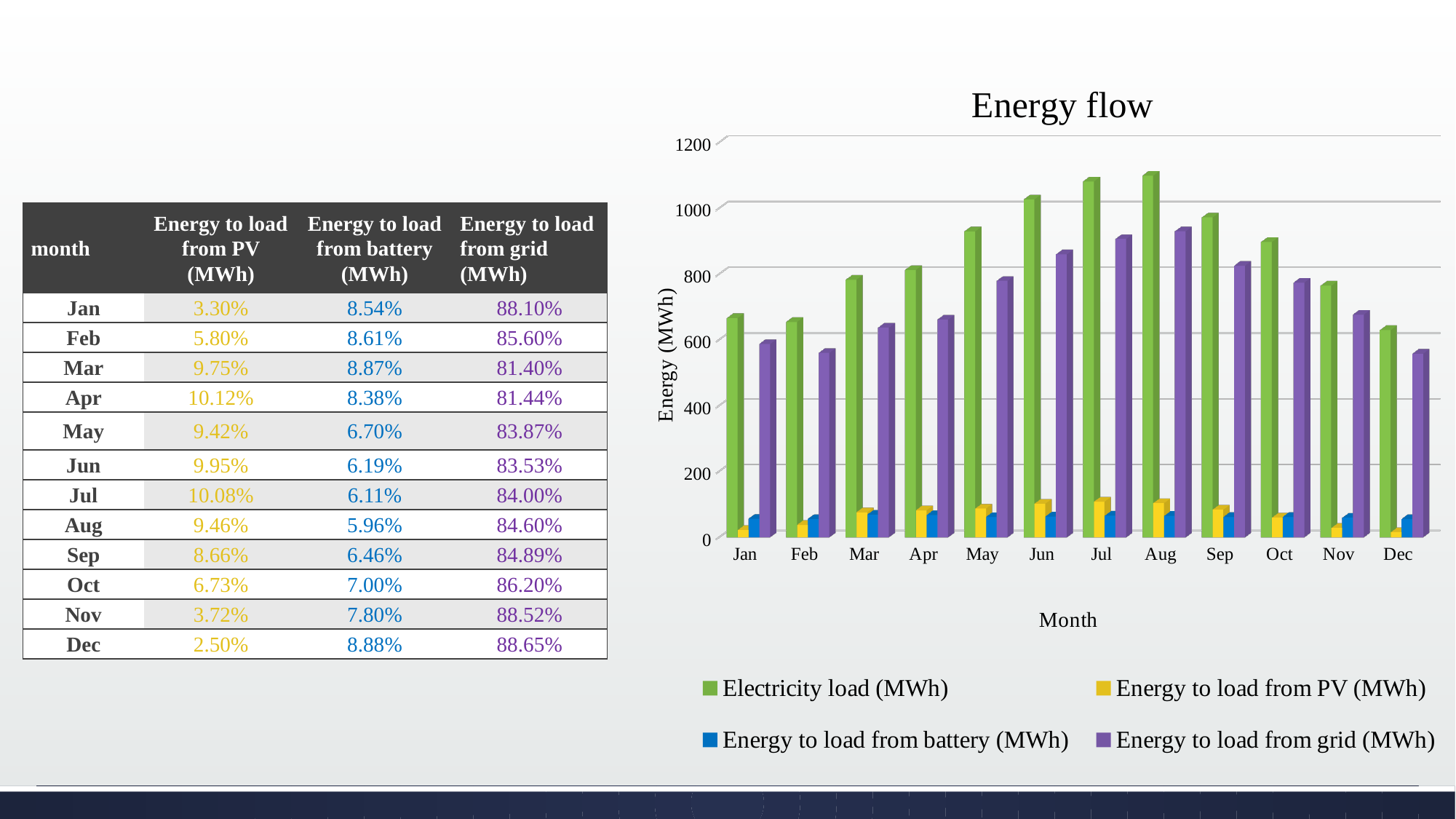
In the Energy flow chart, is the Electricity load (MWh) for Jan greater or less than 800? less How many months are shown on the x axis of the Energy flow chart? 12 In the Energy flow chart, is the Electricity load (MWh) for Jun greater or less than 1000? greater In the Energy flow chart, which is larger: the Energy to load from grid (MWh) for Aug or for Jan? Aug What kind of chart is the Energy flow chart? bar chart How many series does the legend of the Energy flow chart list? 4 In the Energy flow chart, how does the Electricity load (MWh) change from Jan to Aug? It rises In the Energy flow chart, which month has the lowest Electricity load (MWh)? Dec In the Energy flow chart, is the Energy to load from PV (MWh) for Jun greater or less than 200? less In the Energy flow chart, which month has the highest Electricity load (MWh)? Aug What is the y-axis label of the Energy flow chart? Energy (MWh)